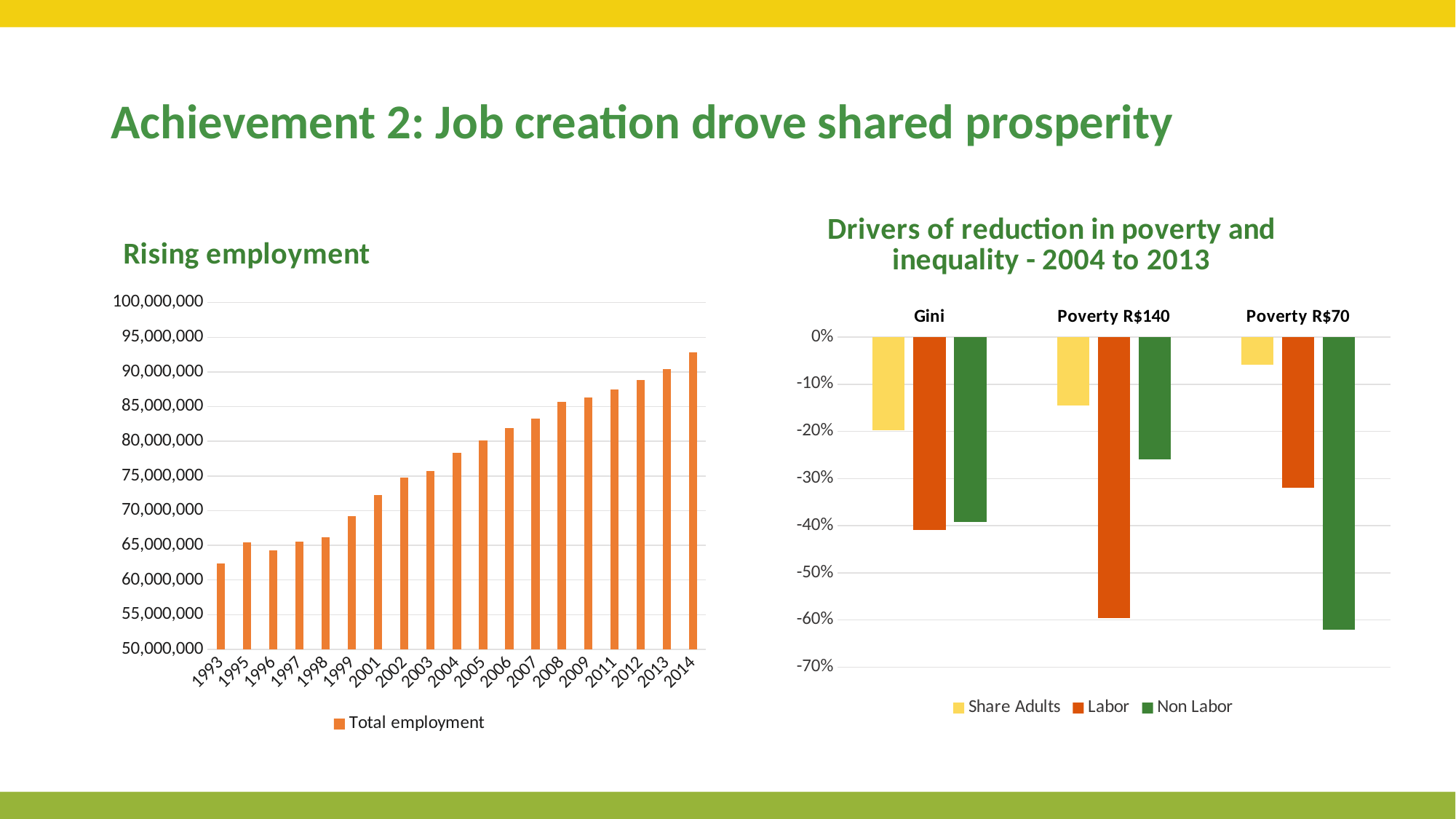
In the 'Rising employment' chart, which year has the highest total employment? 2014 In the 'Drivers of reduction in poverty and inequality - 2004 to 2013' chart, is the Share Adults value for Poverty R$140 greater or less than -10%? less In the 'Rising employment' chart, how many years are shown on the x axis? 19 In the 'Drivers of reduction in poverty and inequality - 2004 to 2013' chart, how many series does the legend list? 3 In the 'Rising employment' chart, is the value for 1993 greater or less than 65,000,000? less In the 'Rising employment' chart, what is the name of the series shown in the legend? Total employment In the 'Rising employment' chart, do the values generally rise or fall from 1993 to 2014? rise In the 'Drivers of reduction in poverty and inequality - 2004 to 2013' chart, how many categories are shown on the x axis? 3 What kind of chart is the 'Rising employment' chart? bar chart In the 'Rising employment' chart, is the value for 2014 greater or less than 90,000,000? greater In the 'Drivers of reduction in poverty and inequality - 2004 to 2013' chart, which series shows the largest reduction for Poverty R$70? Non Labor In the 'Rising employment' chart, which year has the lowest total employment? 1993